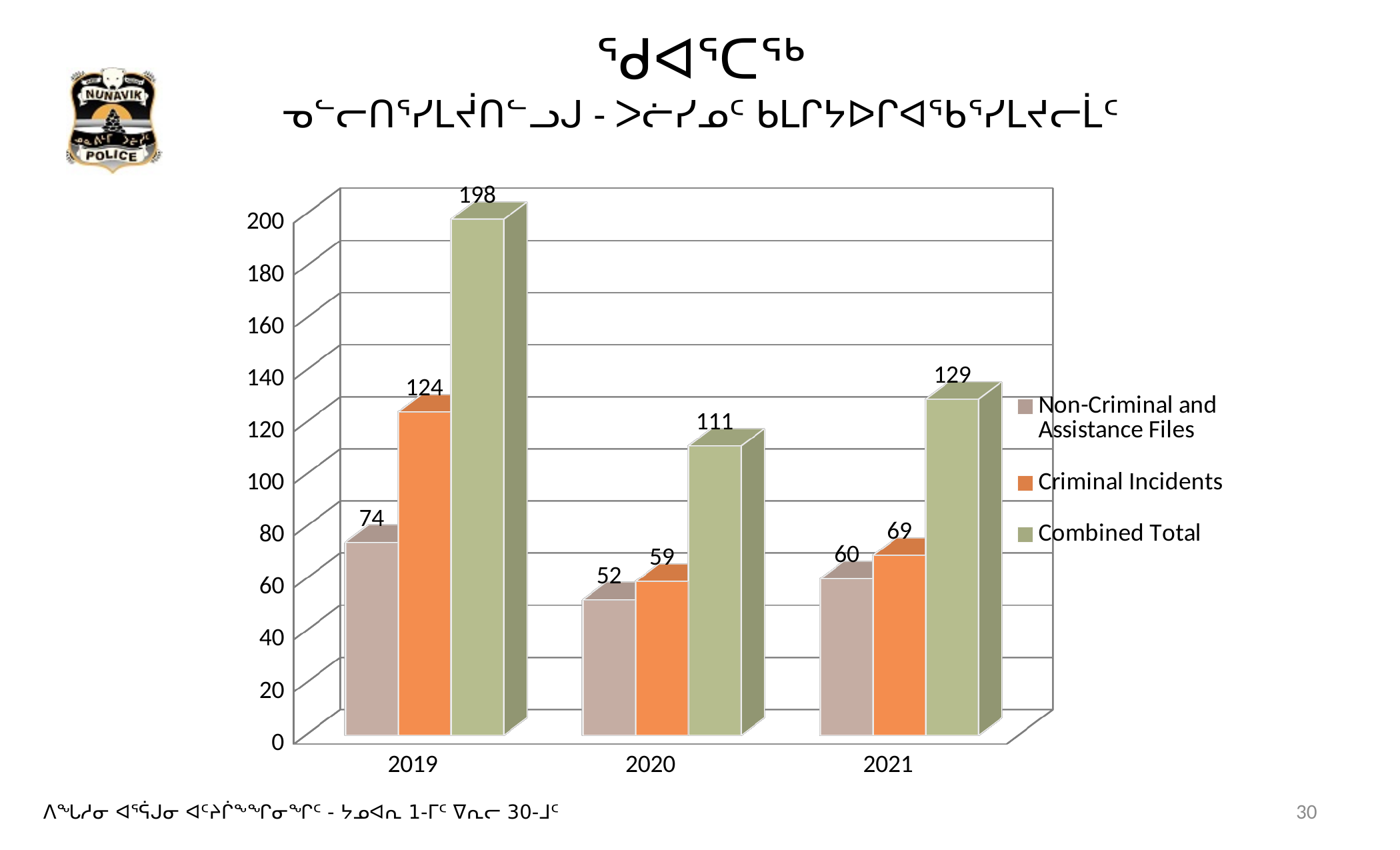
What is the value for Non-Criminal and Assistance Files in 2020? 52 Which year has the lowest value for Criminal Incidents? 2020 What is the value for Criminal Incidents in 2019? 124 Which series is shown in orange in the legend? Criminal Incidents Which year has the highest Combined Total? 2019 What is the difference between the Combined Total in 2019 and in 2020? 87 What kind of chart is shown on the slide? bar chart Which is larger: Non-Criminal and Assistance Files in 2021 or Criminal Incidents in 2021? Criminal Incidents in 2021 How many series does the legend list? 3 Does the Combined Total rise or fall from 2019 to 2020? fall What is the Combined Total for 2021? 129 How many years are shown on the x axis? 3